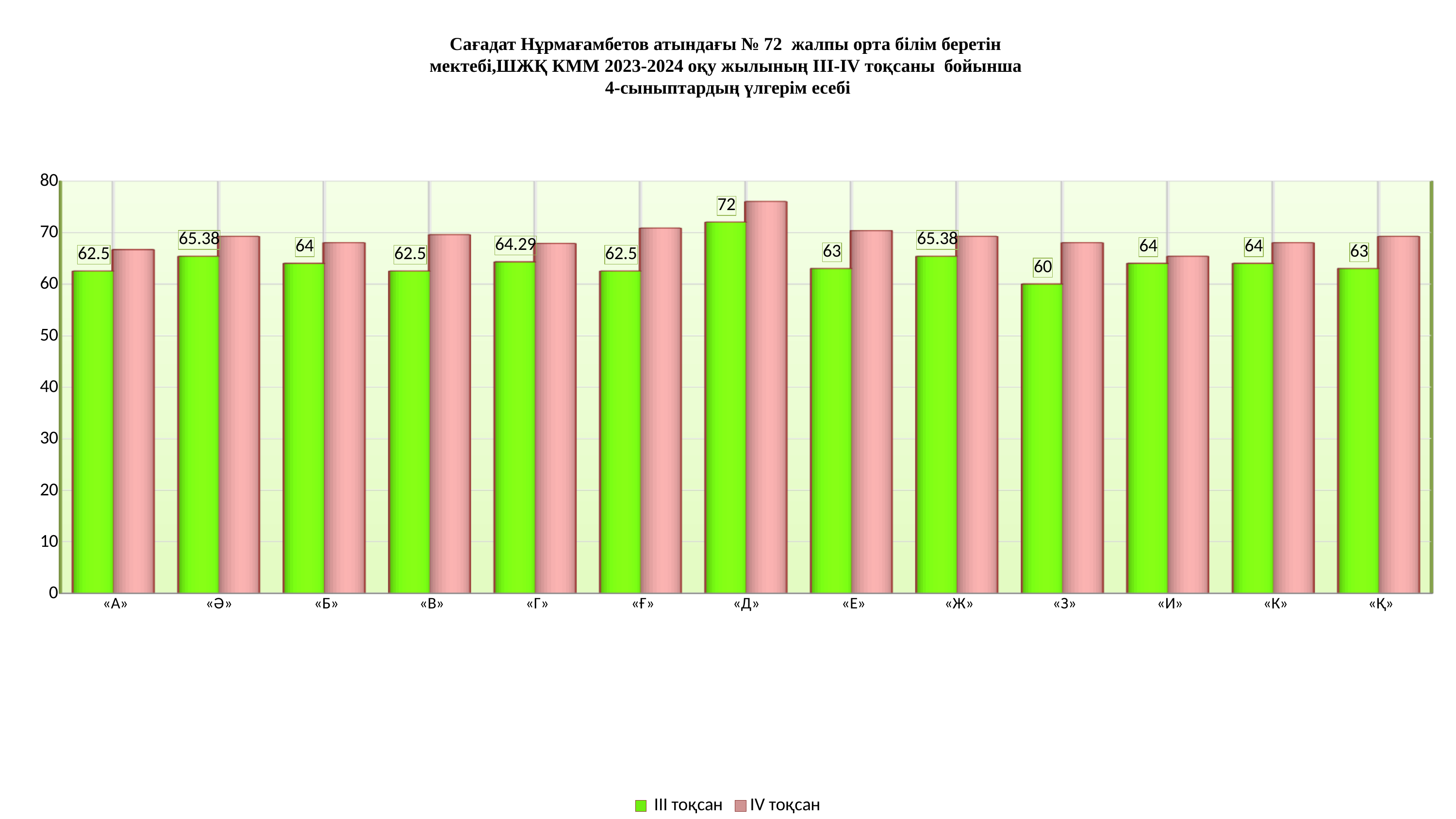
How many classes are shown on the x axis? 13 Which class has the lowest III тоқсан value? «З» Is the IV тоқсан value for «Д» greater or less than 70? greater What is the difference between the III тоқсан values for «Д» and «З»? 12 Is the IV тоқсан value for «И» greater or less than 60? greater Which class has the highest III тоқсан value? «Д» What is the III тоқсан value for «З»? 60 How many series does the legend list? 2 What is the III тоқсан value for «Д»? 72 What kind of chart is shown on the slide? bar chart What is the III тоқсан value for «Г»? 64.29 Which has the larger III тоқсан value, «Ә» or «Б»? «Ә»